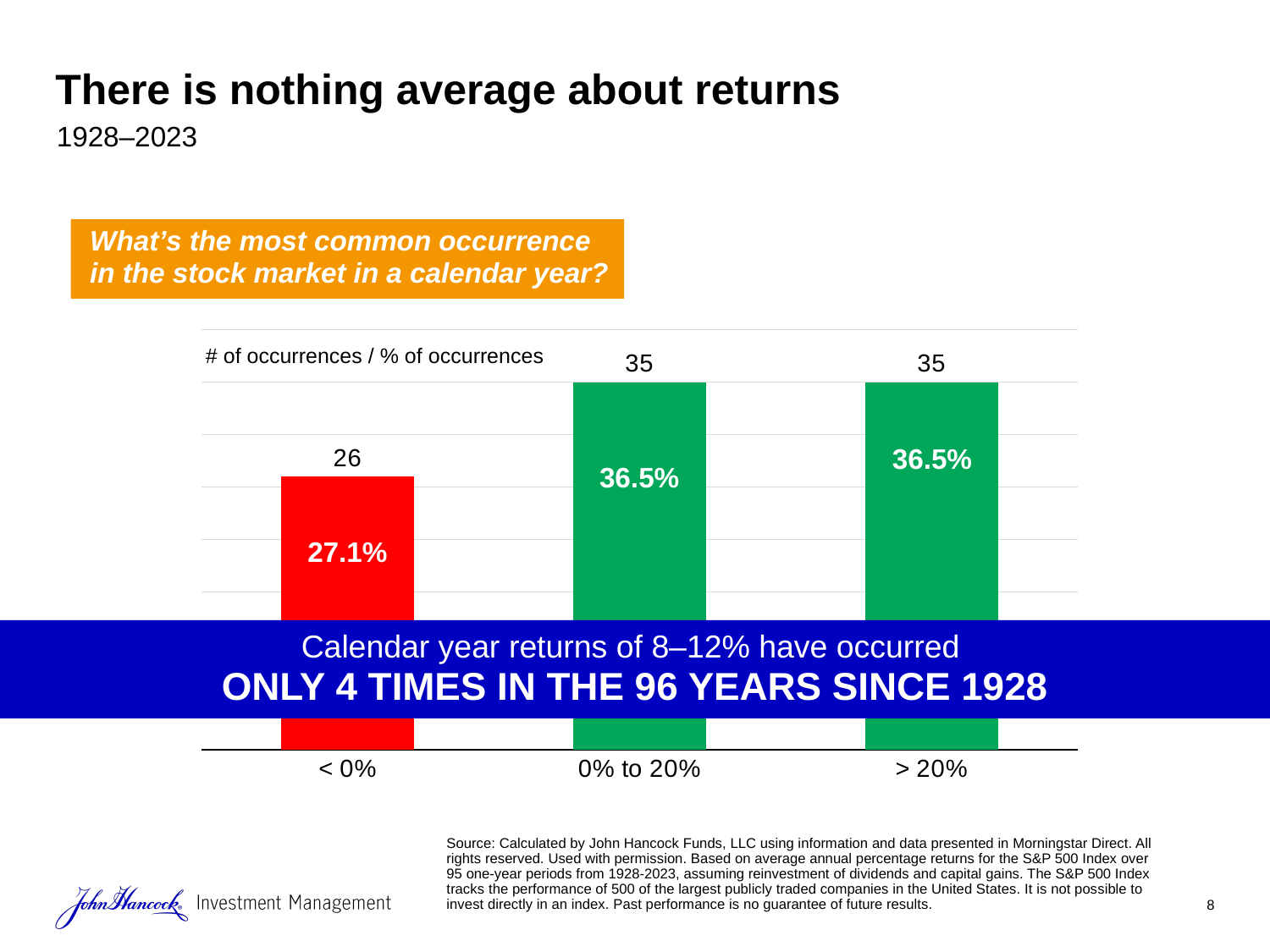
What is the difference in number of occurrences between the 0% to 20% category and the < 0% category? 9 What percentage of occurrences is shown for the 0% to 20% category? 36.5% Do the number of occurrences rise or fall from the < 0% category to the 0% to 20% category? Rise What percentage of occurrences is shown for the < 0% category? 27.1% How many occurrences are shown for the < 0% category? 26 What colour is the bar for the < 0% category? Red What kind of chart is shown on the slide? Bar chart Which has more occurrences, the < 0% category or the > 20% category? > 20% How many occurrences are shown for the > 20% category? 35 How many categories are shown on the x axis of the chart? 3 What label appears at the top left of the chart describing the values shown? # of occurrences / % of occurrences Which category has the lowest number of occurrences? < 0%